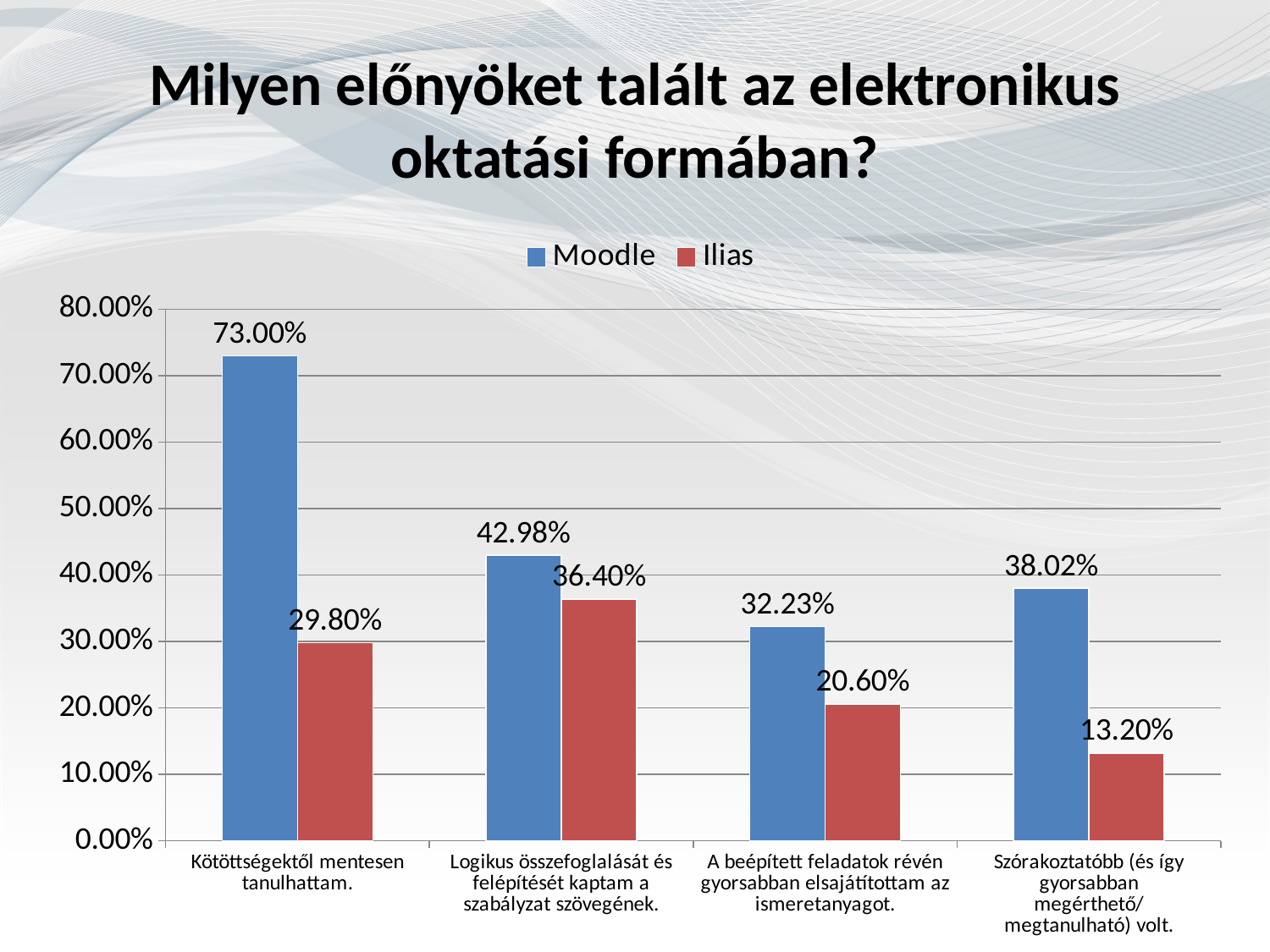
Which category has the lowest Ilias value? Szórakoztatóbb (és így gyorsabban megérthető/megtanulható) volt. Which is larger: the Moodle value for "Szórakoztatóbb (és így gyorsabban megérthető/megtanulható) volt." or the Ilias value for "Logikus összefoglalását és felépítését kaptam a szabályzat szövegének."? Moodle value for "Szórakoztatóbb (és így gyorsabban megérthető/megtanulható) volt." Which category has the highest Moodle value? Kötöttségektől mentesen tanulhattam. What kind of chart is shown on the slide? Bar chart What is the Ilias value for "Logikus összefoglalását és felépítését kaptam a szabályzat szövegének."? 36.40% How many categories are shown on the x axis? 4 Which colour represents the Ilias series? Red What is the Moodle value for "Kötöttségektől mentesen tanulhattam."? 73.00% What is the Ilias value for "Szórakoztatóbb (és így gyorsabban megérthető/megtanulható) volt."? 13.20% What is the difference between the Moodle and Ilias values for "A beépített feladatok révén gyorsabban elsajátítottam az ismeretanyagot."? 11.63% How many series does the legend list? 2 What is the difference between the Moodle and Ilias values for "Kötöttségektől mentesen tanulhattam."? 43.20%